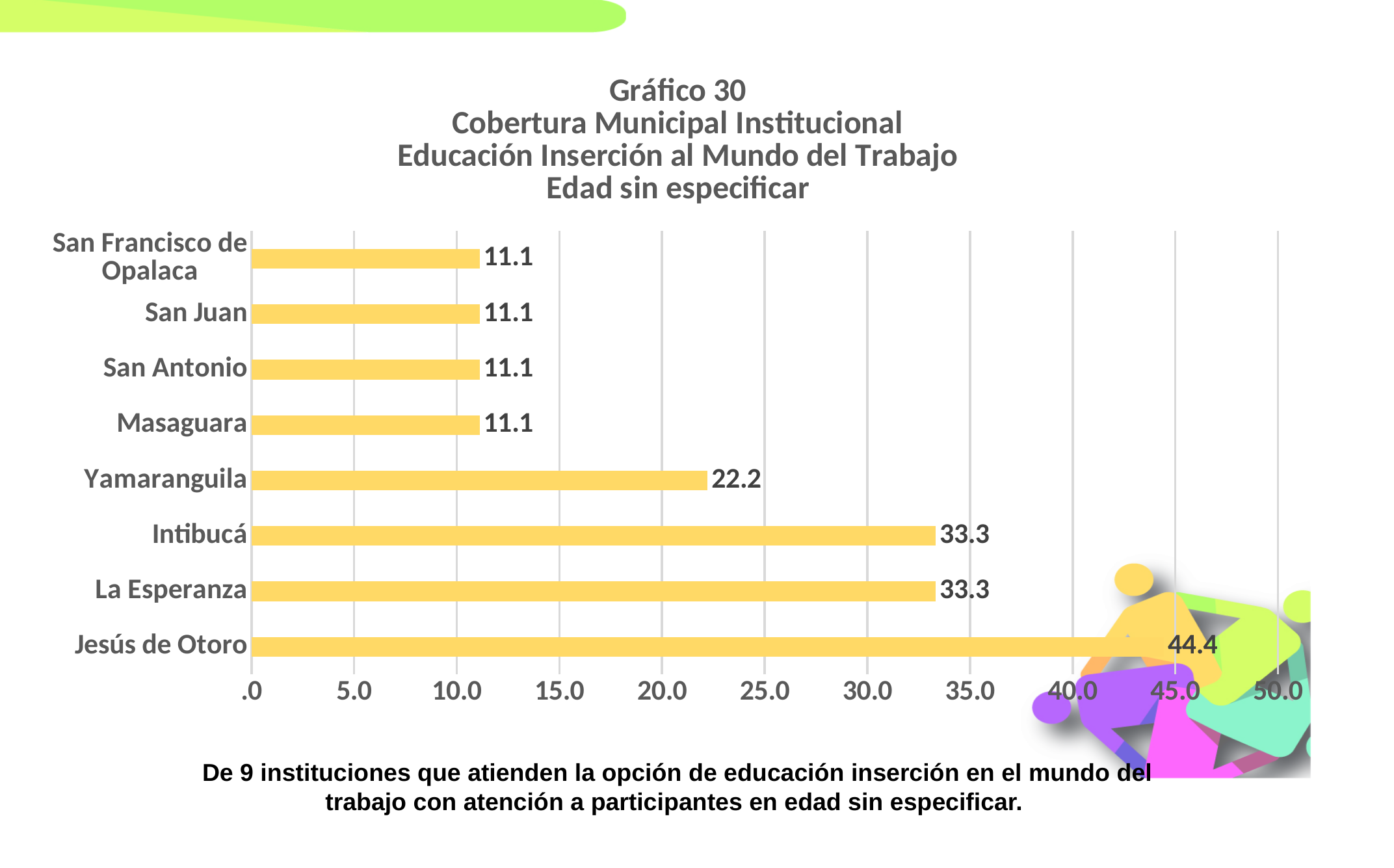
What is the value for Masaguara? 11.1 What is the number of the chart given in its title? Gráfico 30 What is the value for Yamaranguila? 22.2 How many municipalities are shown in the chart? 8 What is the value for Jesús de Otoro? 44.4 What is the difference between the values for La Esperanza and San Juan? 22.2 Is the value for Jesús de Otoro greater or less than 40.0? greater What is the value for Intibucá? 33.3 What is the difference between the values for Jesús de Otoro and Yamaranguila? 22.2 What kind of chart is shown on the slide? bar chart Which is larger, the value for Yamaranguila or the value for San Antonio? Yamaranguila Which municipality has the highest value? Jesús de Otoro